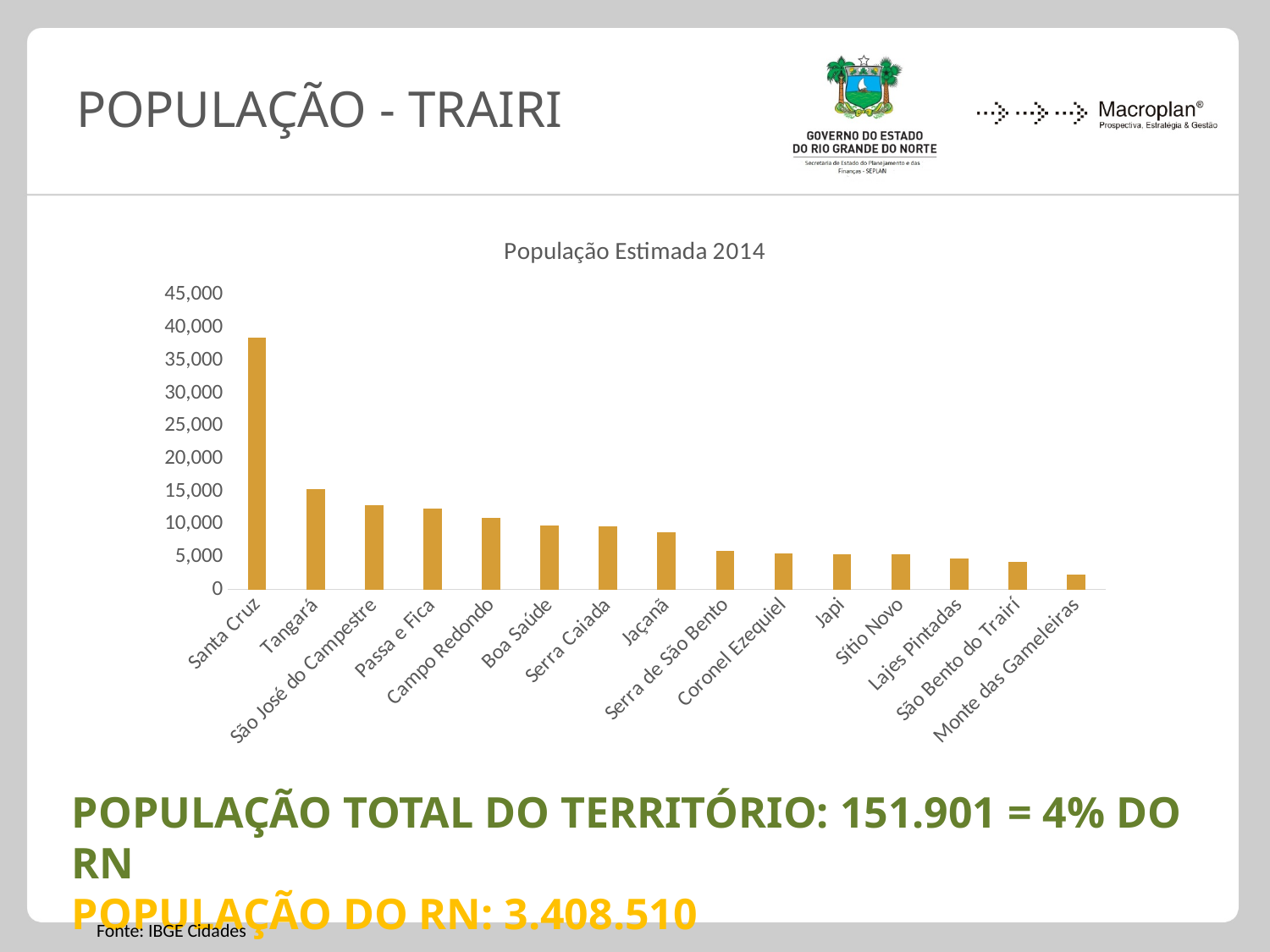
Which municipality has the lowest estimated population in the chart? Monte das Gameleiras How many municipalities are shown on the x axis of the chart? 15 What source is cited for the chart data at the bottom of the slide? IBGE Cidades Is the value for Monte das Gameleiras greater or less than 5,000? less Which municipality has the highest estimated population in the chart? Santa Cruz What type of chart is shown on the slide? bar chart Which has a larger estimated population, Tangará or Jaçanã? Tangará Is the value for Tangará greater or less than 10,000? greater Is the value for Santa Cruz greater or less than 35,000? greater What is the title of the chart? População Estimada 2014 Do the bar values rise or fall from left to right along the x axis? fall